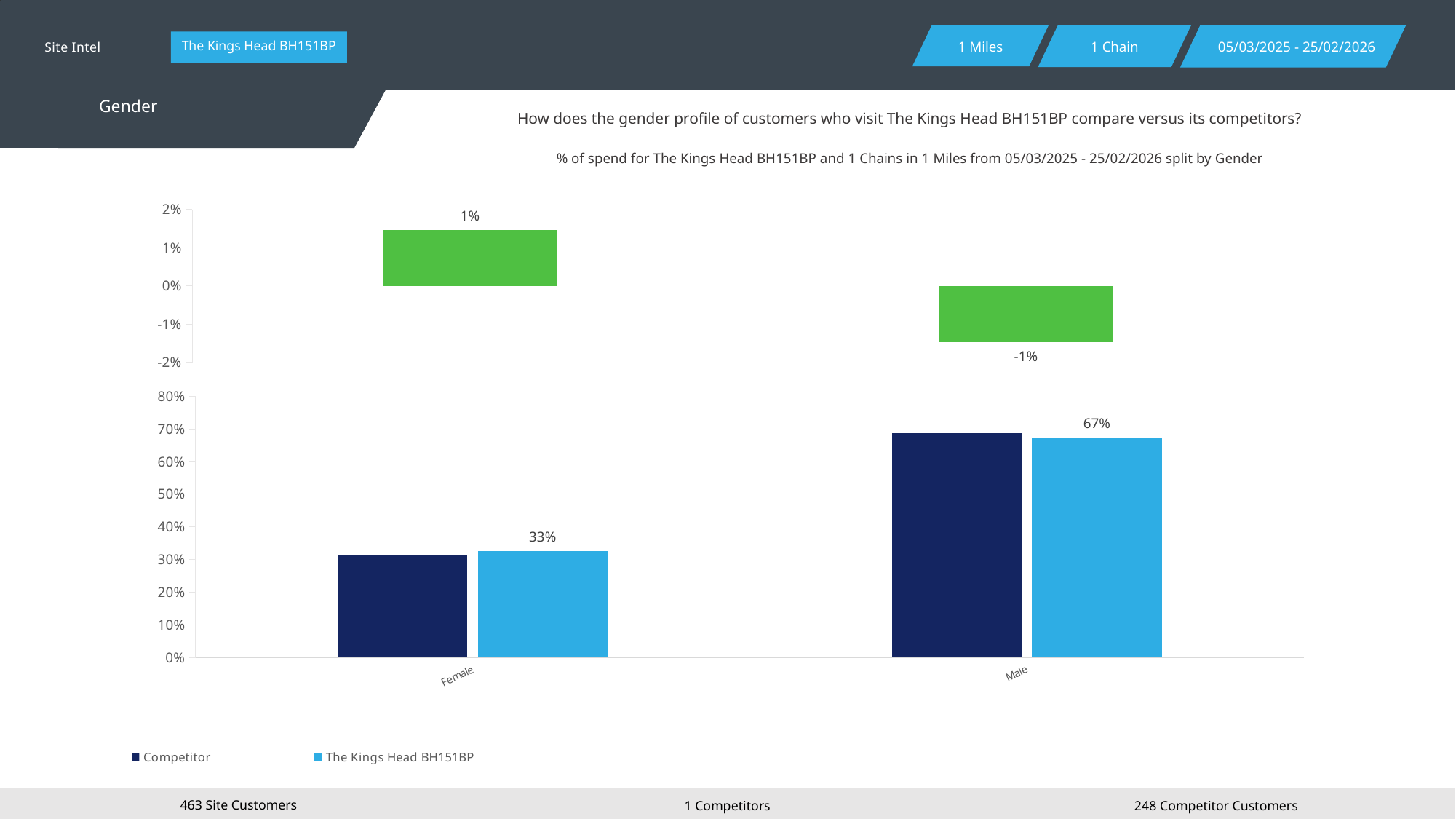
In the top chart, what is the value shown for Female? 1% What type of chart is the bottom chart? Bar chart How many gender categories are shown on the x axis of the bottom chart? 2 In the bottom bar chart, what is the value for The Kings Head BH151BP for Female? 33% In the top chart, what is the value shown for Male? -1% In the bottom bar chart, for Male, which is larger: the Competitor value or The Kings Head BH151BP value? Competitor In the bottom bar chart, what is the value for The Kings Head BH151BP for Male? 67% In the bottom bar chart, is the Competitor value for Female greater or less than 40%? less How many series does the legend of the bottom bar chart list? 2 In the bottom bar chart, which gender category has the highest value for The Kings Head BH151BP? Male In the bottom bar chart, what is the difference between The Kings Head BH151BP values for Male and Female? 34% In the bottom bar chart, is the Competitor value for Male greater or less than 60%? greater